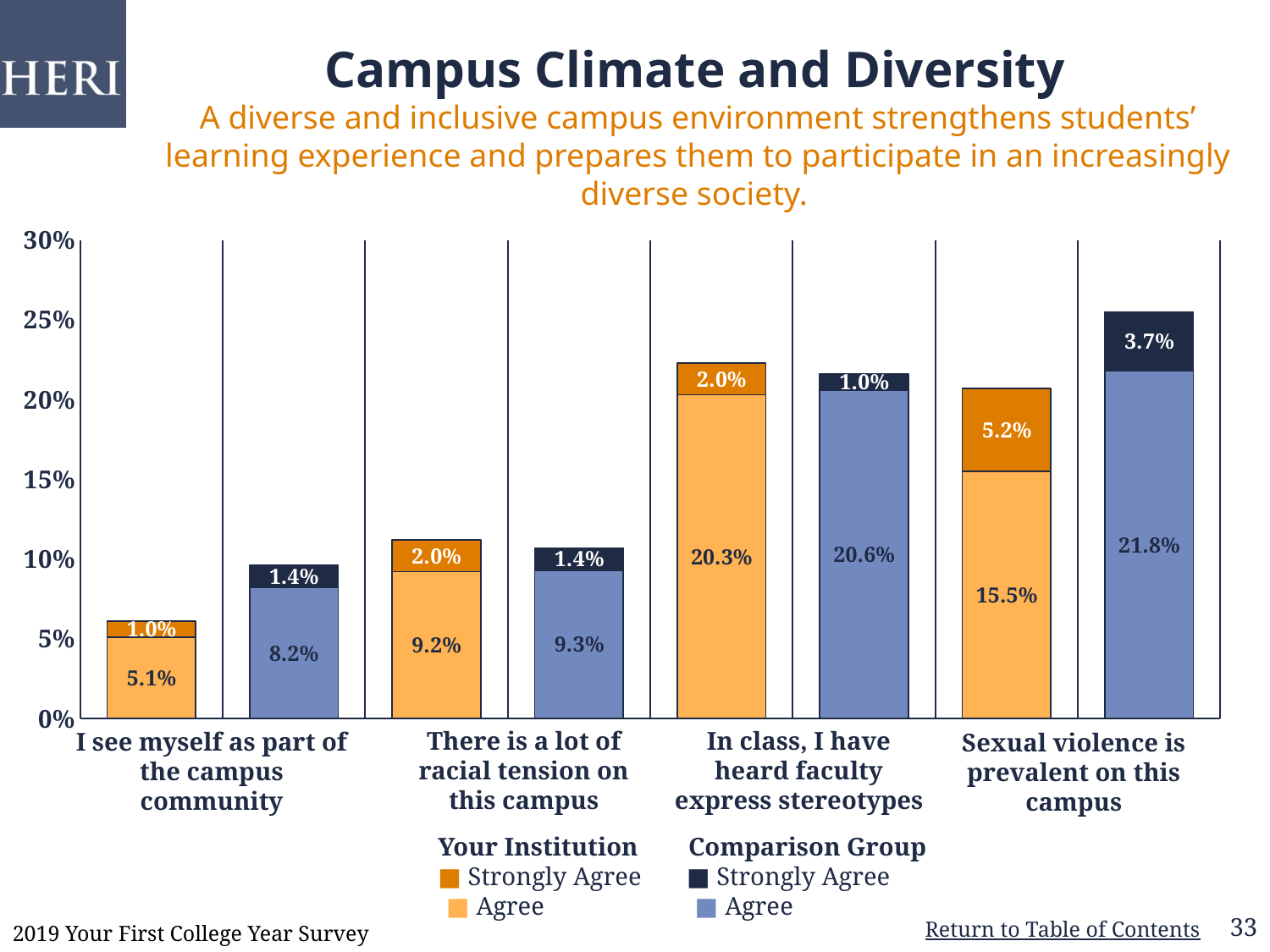
What is the total (Agree plus Strongly Agree) for Your Institution on 'Sexual violence is prevalent on this campus'? 20.7% What is the difference between the Comparison Group Agree value and the Your Institution Agree value for 'Sexual violence is prevalent on this campus'? 6.3% Is the total stacked bar for the Comparison Group on 'Sexual violence is prevalent on this campus' greater or less than 25%? greater What percentage of Comparison Group students Strongly Agree that 'Sexual violence is prevalent on this campus'? 3.7% What percentage of Your Institution students Agree that 'In class, I have heard faculty express stereotypes'? 20.3% Which statement has the lowest Your Institution Agree value? I see myself as part of the campus community What percentage of Your Institution students Agree that 'I see myself as part of the campus community'? 5.1% Which statement has the highest Comparison Group Agree value? Sexual violence is prevalent on this campus Which has the larger Strongly Agree value for 'Sexual violence is prevalent on this campus', Your Institution or the Comparison Group? Your Institution What kind of chart is shown on the slide? Stacked bar chart How many statements (categories) are shown on the x axis of the chart? 4 What is the total (Agree plus Strongly Agree) for the Comparison Group on 'I see myself as part of the campus community'? 9.6%